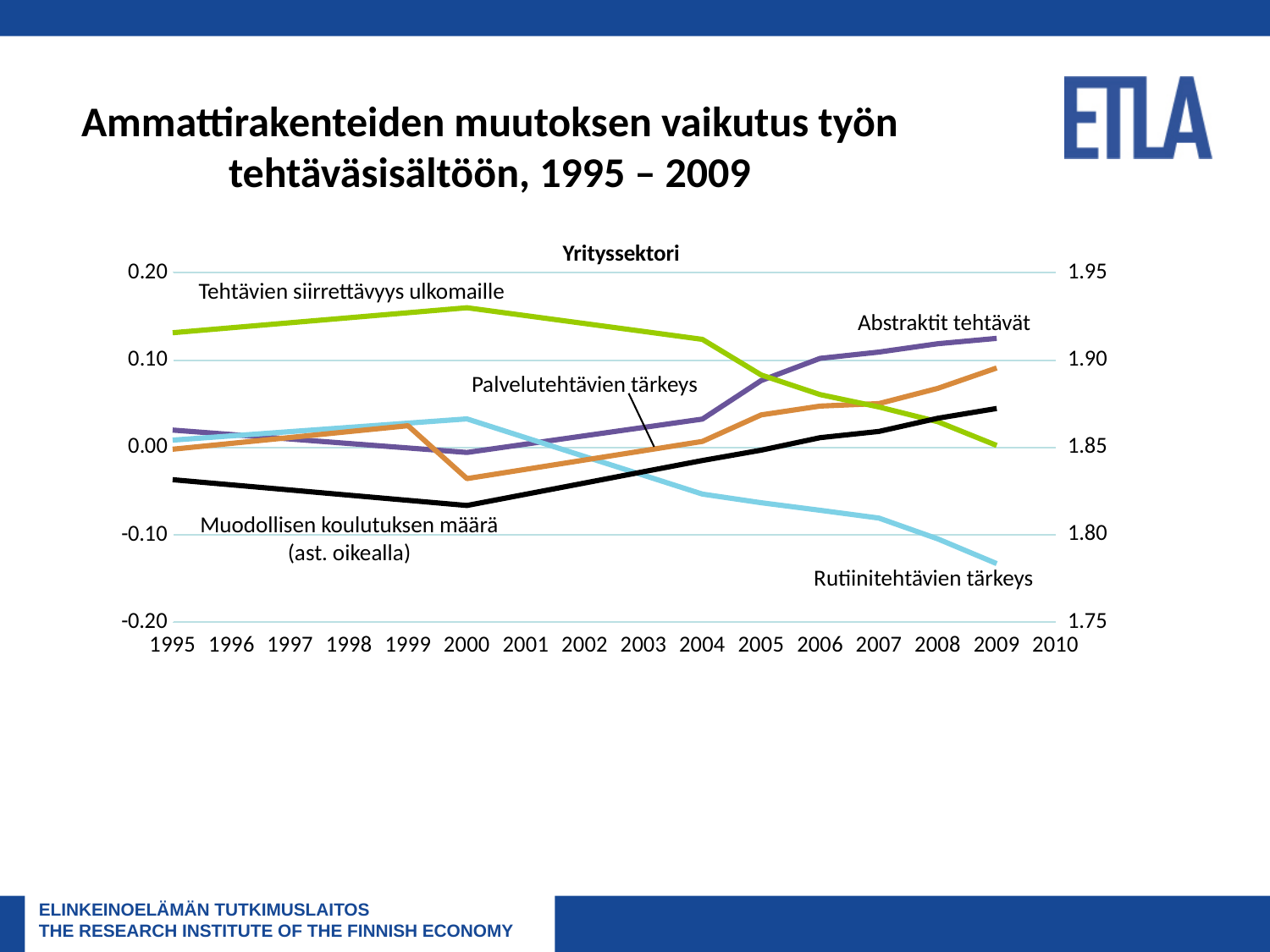
In 2009, which is higher: Abstraktit tehtävät or Palvelutehtävien tärkeys? Abstraktit tehtävät Which series has the highest value in 2000? Tehtävien siirrettävyys ulkomaille What is the title printed above the chart's plot area? Yrityssektori Which series is plotted against the right-hand axis? Muodollisen koulutuksen määrä Is the value for Abstraktit tehtävät in 2009 greater or less than 0.10? greater Is the value for Tehtävien siirrettävyys ulkomaille in 2000 greater or less than 0.10? greater Is the value for Muodollisen koulutuksen määrä in 2000 greater or less than 1.85 on the right axis? less Does the Abstraktit tehtävät line rise or fall from 1995 to 2009? Rise How many series are plotted in the chart? 5 Does the Rutiinitehtävien tärkeys line rise or fall from 1995 to 2009? Fall What kind of chart is shown on the slide? Line chart